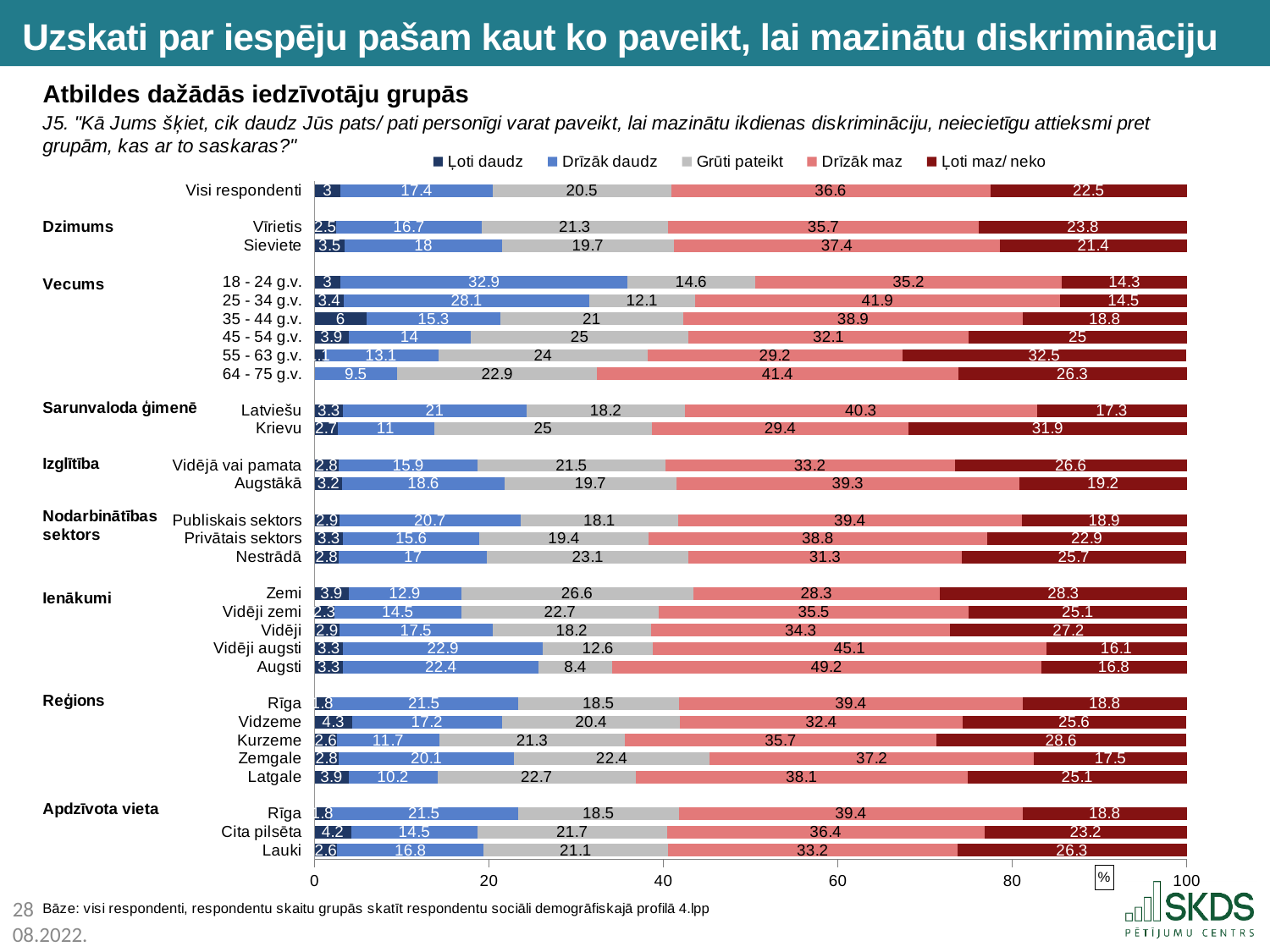
How many series does the legend list? 5 What is the value of 'Drīzāk maz' for 'Visi respondenti'? 36.6 What is the value of 'Drīzāk daudz' for '18 - 24 g.v.'? 32.9 What is the difference between the 'Drīzāk daudz' values for 'Latviešu' and 'Krievu'? 10 What is the value of 'Ļoti maz/ neko' for 'Krievu'? 31.9 What is the last entry in the legend? Ļoti maz/ neko What is the value of 'Grūti pateikt' for 'Augsti'? 8.4 Which category has the highest value for 'Drīzāk daudz'? 18 - 24 g.v. Which has a larger 'Ļoti maz/ neko' value, 'Latviešu' or 'Krievu'? Krievu How many categories are listed under 'Reģions'? 5 Which category has the highest value for 'Drīzāk maz'? Augsti What kind of chart is shown on the slide? Stacked bar chart